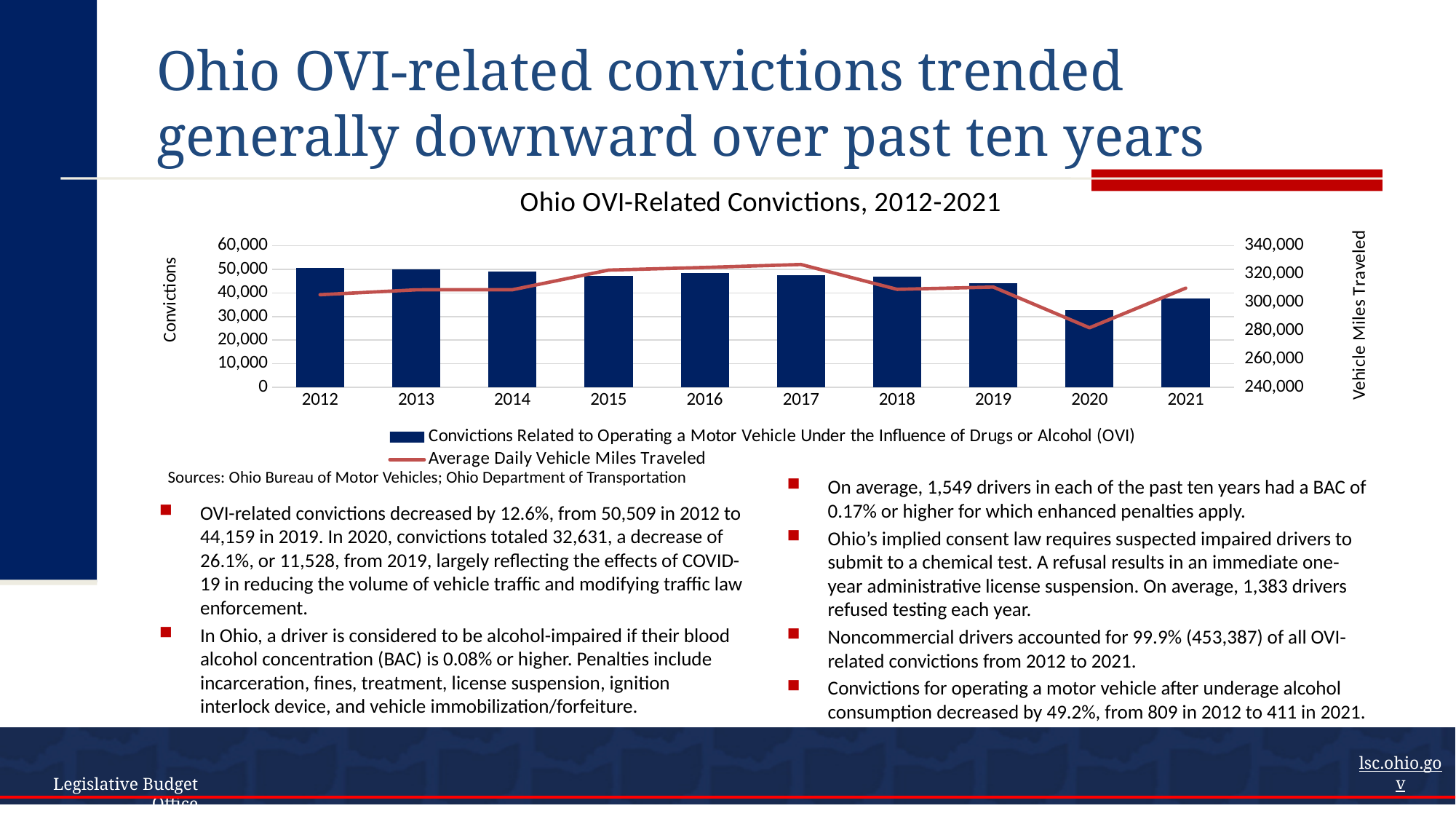
In which year does the Average Daily Vehicle Miles Traveled line reach its highest point? 2017 Do OVI-related convictions generally rise or fall from 2012 to 2021? fall How many years are shown on the x axis of the chart? 10 Is the Average Daily Vehicle Miles Traveled value for 2020 greater or less than 300,000? less Which series is drawn as a line in the chart? Average Daily Vehicle Miles Traveled Are OVI-related convictions higher in 2012 or in 2021? 2012 How many series does the chart legend list? 2 Is the number of convictions in 2020 greater or less than 40,000? less Which year has the lowest number of OVI-related convictions? 2020 What kind of chart is shown on the slide? A combination bar and line chart Is the number of convictions in 2015 greater or less than 40,000? greater What is the title of the chart? Ohio OVI-Related Convictions, 2012-2021